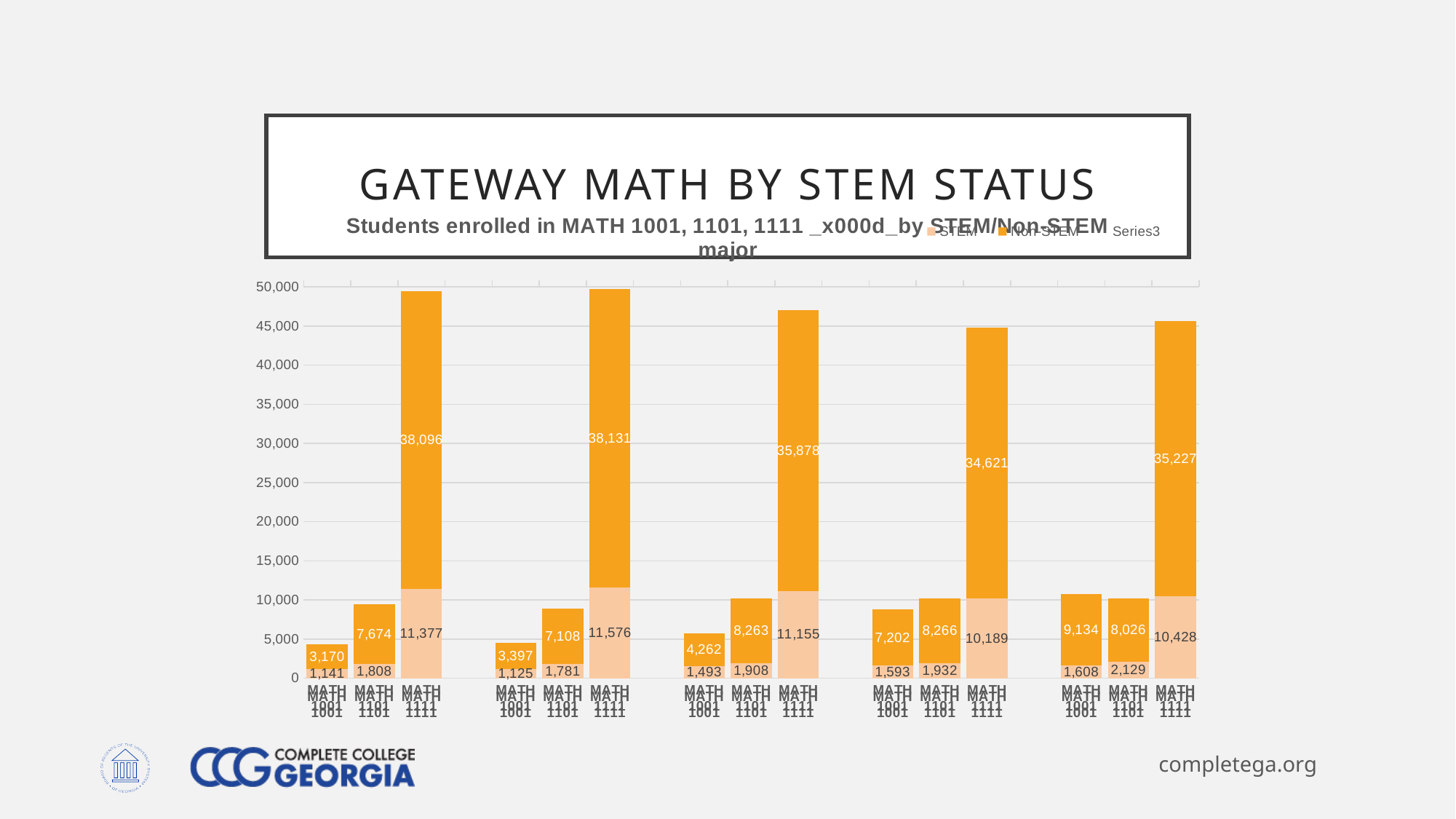
In the leftmost group, what is the total height of the MATH 1111 stacked bar (STEM plus Non-STEM)? 49,473 What kind of chart is shown on the slide? Stacked bar chart What are the entries in the chart legend? STEM, Non-STEM, Series3 In the leftmost group, what is the difference between the Non-STEM values for MATH 1101 and MATH 1001? 4,504 In the rightmost group, which has the larger Non-STEM value, MATH 1001 or MATH 1101? MATH 1001 In the leftmost group of bars, what is the STEM value for MATH 1001? 1,141 How many series does the chart legend list? 3 Which bar has the highest Non-STEM value on the chart? MATH 1111 in the second group from the left (38,131) How many bars are in each group on the chart? 3 In the rightmost group of bars, what is the STEM value for MATH 1101? 2,129 Which bar has the lowest STEM value on the chart? MATH 1001 in the second group from the left (1,125) In the leftmost group of bars, what is the Non-STEM value for MATH 1111? 38,096